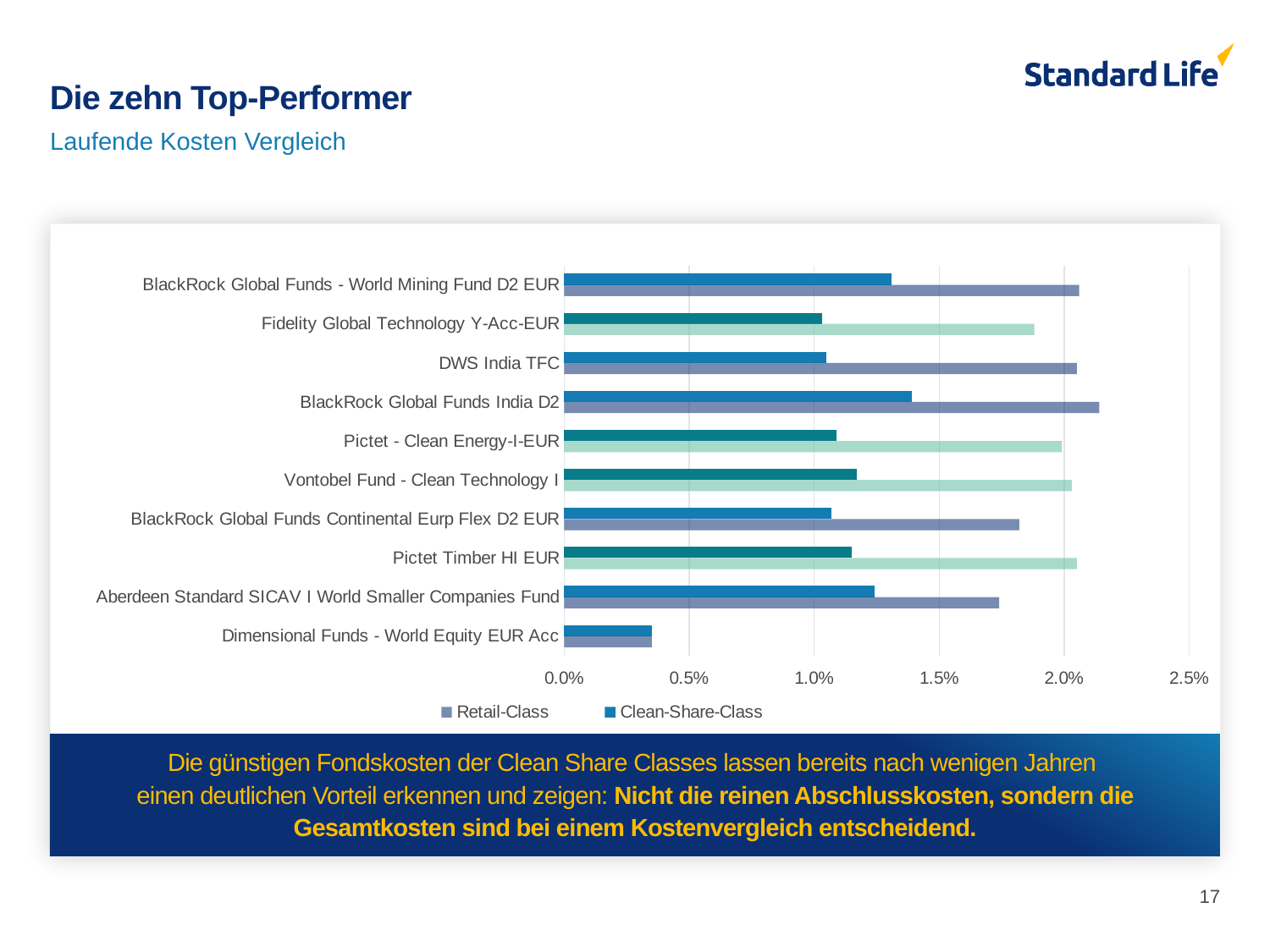
Which fund has the lowest Clean-Share-Class value? Dimensional Funds - World Equity EUR Acc How many series does the legend list? 2 Is the Clean-Share-Class value for Dimensional Funds - World Equity EUR Acc greater or less than 0.5%? less Which fund has the highest Retail-Class value? BlackRock Global Funds India D2 Is the Retail-Class value for Fidelity Global Technology Y-Acc-EUR greater or less than 2.0%? less What kind of chart is shown on the slide? Bar chart For DWS India TFC, which is larger: the Retail-Class value or the Clean-Share-Class value? Retail-Class Is the Retail-Class value for BlackRock Global Funds India D2 greater or less than 2.0%? greater How many funds are listed on the chart? 10 What are the two series named in the legend? Retail-Class and Clean-Share-Class